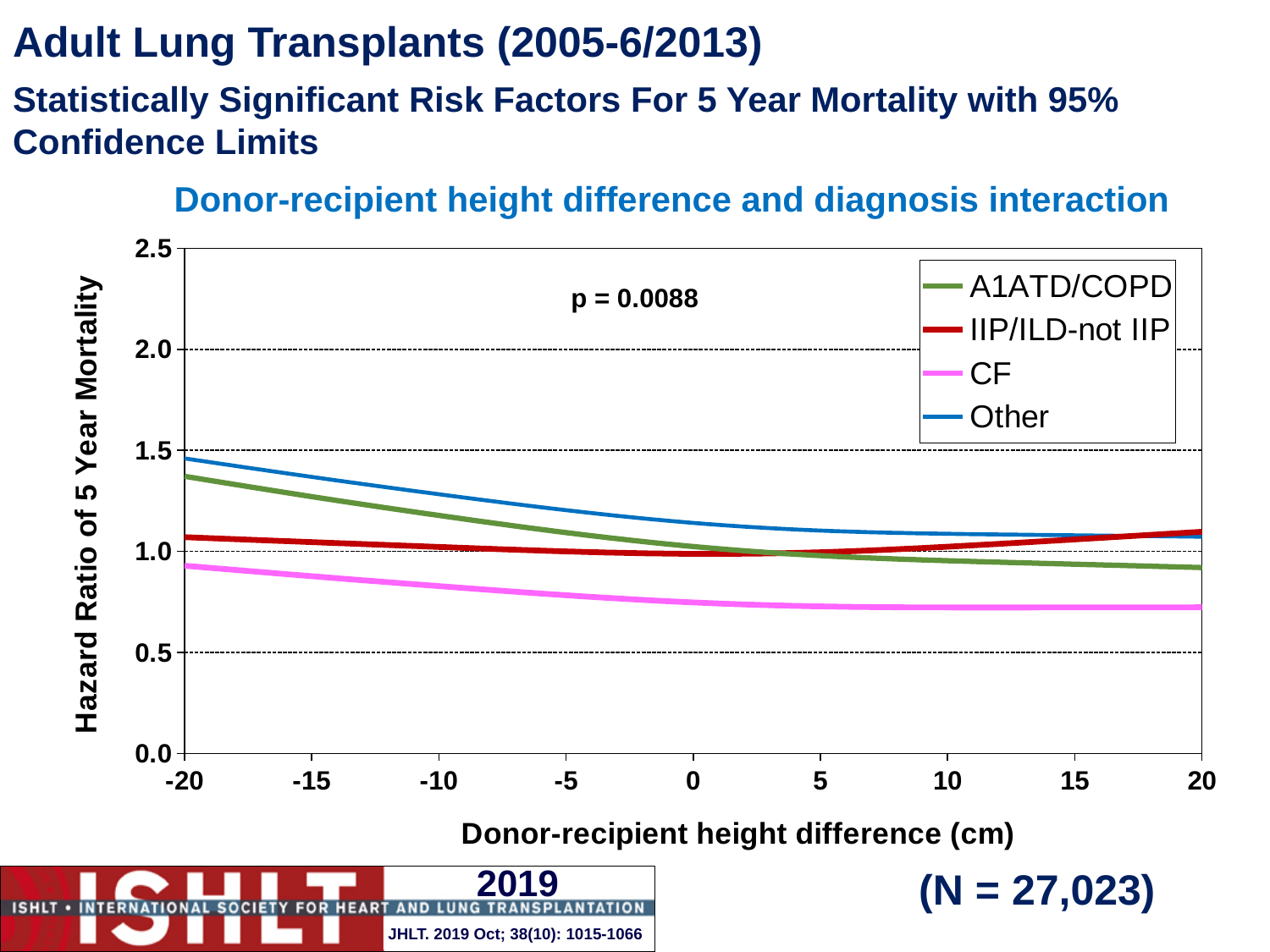
What kind of chart is shown on the slide? line chart How many series does the legend list? 4 Which series has the highest hazard ratio at a height difference of -20 cm? Other Is the hazard ratio for CF at a height difference of -20 cm greater or less than 1.0? less Is the hazard ratio for CF at a height difference of 20 cm greater or less than 0.5? greater Is the hazard ratio for A1ATD/COPD at a height difference of -20 cm greater or less than 1.0? greater At a height difference of -20 cm, which has the larger hazard ratio: A1ATD/COPD or IIP/ILD-not IIP? A1ATD/COPD Does the hazard ratio for A1ATD/COPD rise or fall as the donor-recipient height difference increases from -20 to 20 cm? fall Which series are listed in the legend? A1ATD/COPD, IIP/ILD-not IIP, CF, Other Which series has the lowest hazard ratio at a height difference of 20 cm? CF What p-value is printed on the chart? p = 0.0088 At a height difference of 20 cm, which has the larger hazard ratio: CF or A1ATD/COPD? A1ATD/COPD